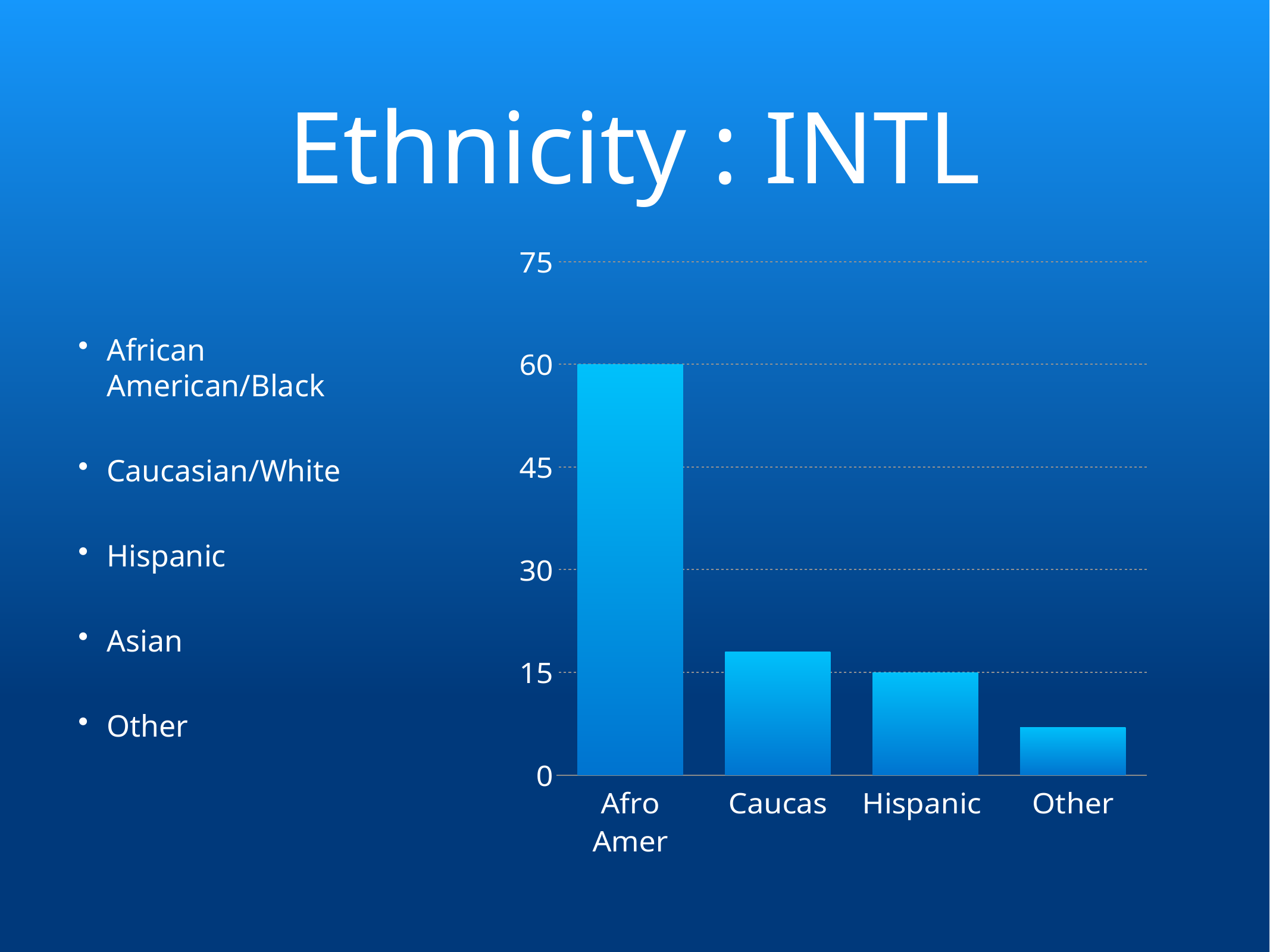
What is the value for Afro Amer? 60 Which is larger, the value for Afro Amer or the value for Caucas? Afro Amer Which category has the highest value? Afro Amer Do the values rise or fall from left to right along the x axis? fall Is the value for Other greater or less than 15? less How many categories are shown on the x axis? 4 What is the difference between the values for Afro Amer and Hispanic? 45 Which category has the lowest value? Other What kind of chart is shown on the slide? bar chart Which is larger, the value for Hispanic or the value for Other? Hispanic What is the value for Hispanic? 15 Is the value for Caucas greater or less than 15? greater